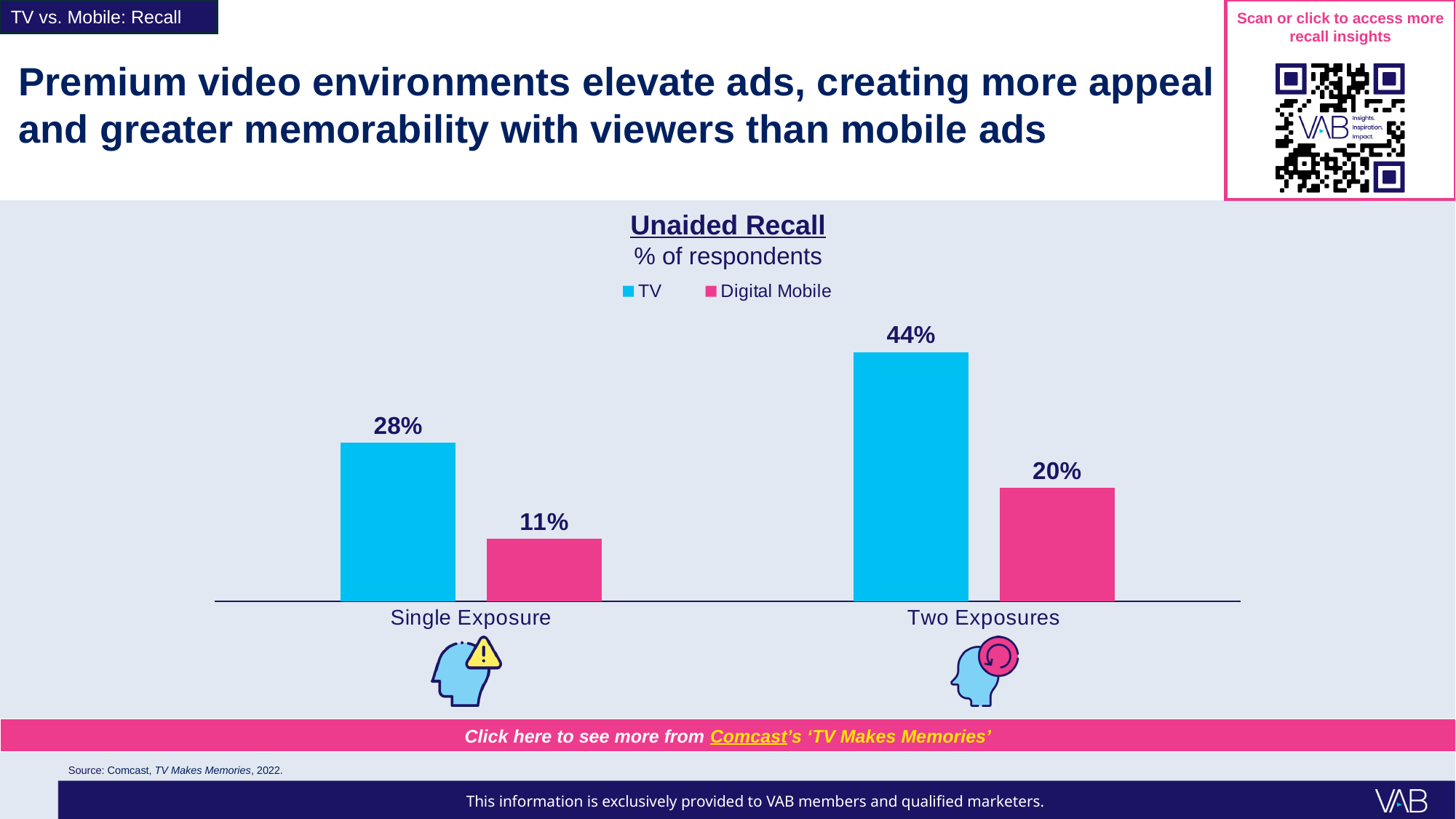
Which bar has the highest value on the chart? TV, Two Exposures What is the unaided recall value for Digital Mobile with two exposures? 20% Which is larger: TV recall with a single exposure or Digital Mobile recall with two exposures? TV recall with a single exposure What is the difference between TV and Digital Mobile unaided recall for two exposures? 24 percentage points What is the title of the chart? Unaided Recall What is the unaided recall value for TV with two exposures? 44% What is the unaided recall value for TV with a single exposure? 28% What is the unaided recall value for Digital Mobile with a single exposure? 11% How many series does the legend list? 2 What is the difference between TV unaided recall for two exposures and for a single exposure? 16 percentage points Which bar has the lowest value on the chart? Digital Mobile, Single Exposure What kind of chart is shown on the slide? Bar chart